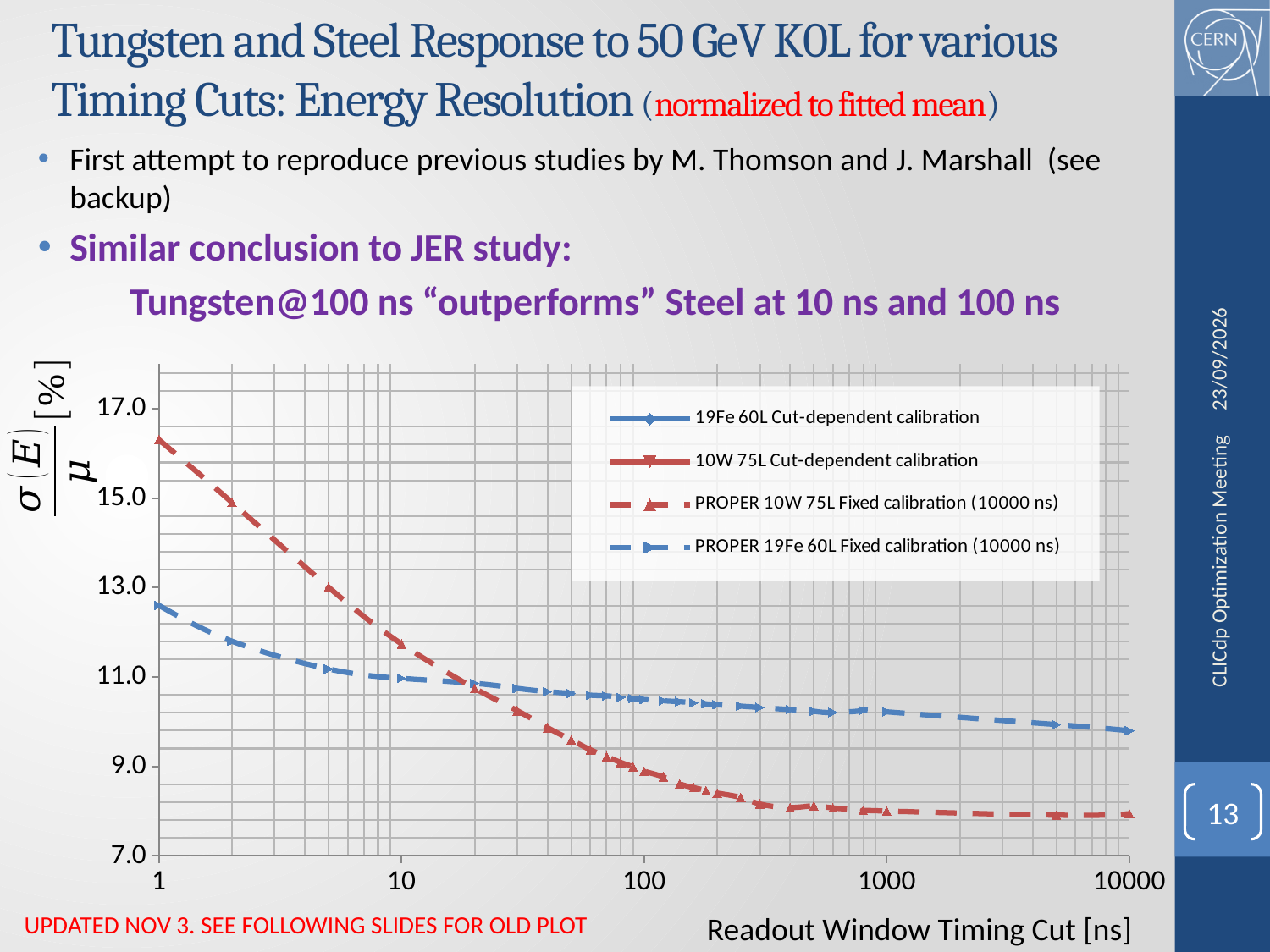
Is the value of the PROPER 10W 75L Fixed calibration (10000 ns) series at a timing cut of 1 ns greater or less than 15.0? greater Is the value of the PROPER 19Fe 60L Fixed calibration (10000 ns) series at a timing cut of 1 ns greater or less than 13.0? less What is the highest tick value shown on the y axis of the chart? 17.0 At a timing cut of 10000 ns, which series has the higher energy resolution value: PROPER 10W 75L Fixed calibration or PROPER 19Fe 60L Fixed calibration? PROPER 19Fe 60L Fixed calibration (10000 ns) At a timing cut of 1 ns, which series has the higher energy resolution value: PROPER 10W 75L Fixed calibration or PROPER 19Fe 60L Fixed calibration? PROPER 10W 75L Fixed calibration (10000 ns) What is the label of the x axis of the chart? Readout Window Timing Cut [ns] What kind of chart is shown on the slide? line chart How many series does the chart legend list? 4 Does the PROPER 10W 75L Fixed calibration (10000 ns) series rise or fall as the timing cut increases along the x axis? fall Does the PROPER 19Fe 60L Fixed calibration (10000 ns) series rise or fall as the timing cut increases along the x axis? fall Is the value of the PROPER 10W 75L Fixed calibration (10000 ns) series at a timing cut of 10000 ns greater or less than 9.0? less